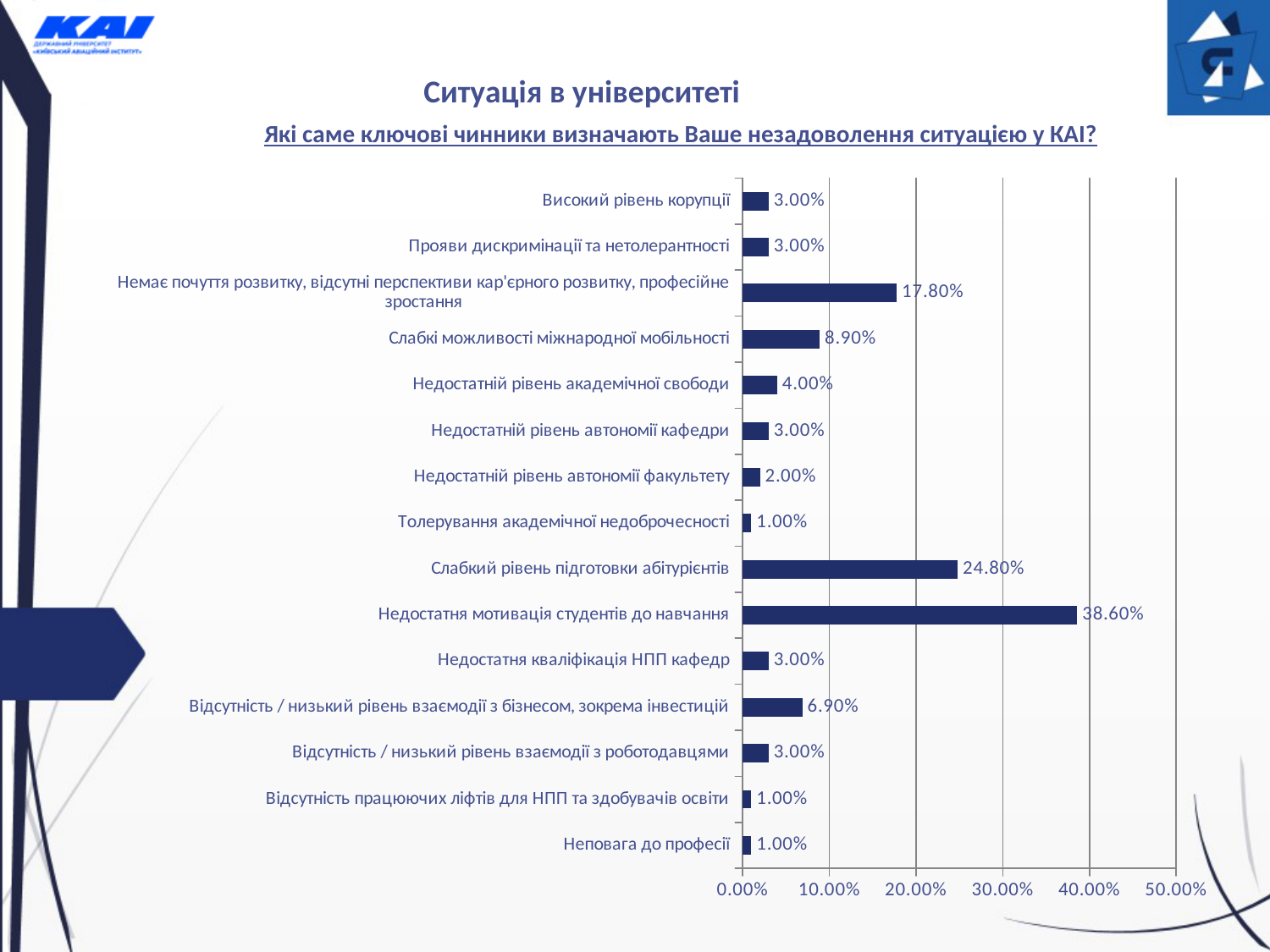
Is the value for "Слабкий рівень підготовки абітурієнтів" greater or less than 20.00%? greater What is the value for "Слабкі можливості міжнародної мобільності"? 8.90% What is the value for "Відсутність / низький рівень взаємодії з бізнесом, зокрема інвестицій"? 6.90% How many categories are shown in the chart? 15 What kind of chart is shown on the slide? bar chart What is the difference between the values for "Немає почуття розвитку, відсутні перспективи кар'єрного розвитку, професійне зростання" and "Слабкі можливості міжнародної мобільності"? 8.90% Which category has the highest value? Недостатня мотивація студентів до навчання Which is larger: the value for "Недостатній рівень академічної свободи" or the value for "Недостатній рівень автономії факультету"? Недостатній рівень академічної свободи What is the value for "Недостатня мотивація студентів до навчання"? 38.60% What is the difference between the values for "Недостатня мотивація студентів до навчання" and "Слабкий рівень підготовки абітурієнтів"? 13.80% What question does the chart's title ask? Які саме ключові чинники визначають Ваше незадоволення ситуацією у КАІ? What is the value for "Слабкий рівень підготовки абітурієнтів"? 24.80%